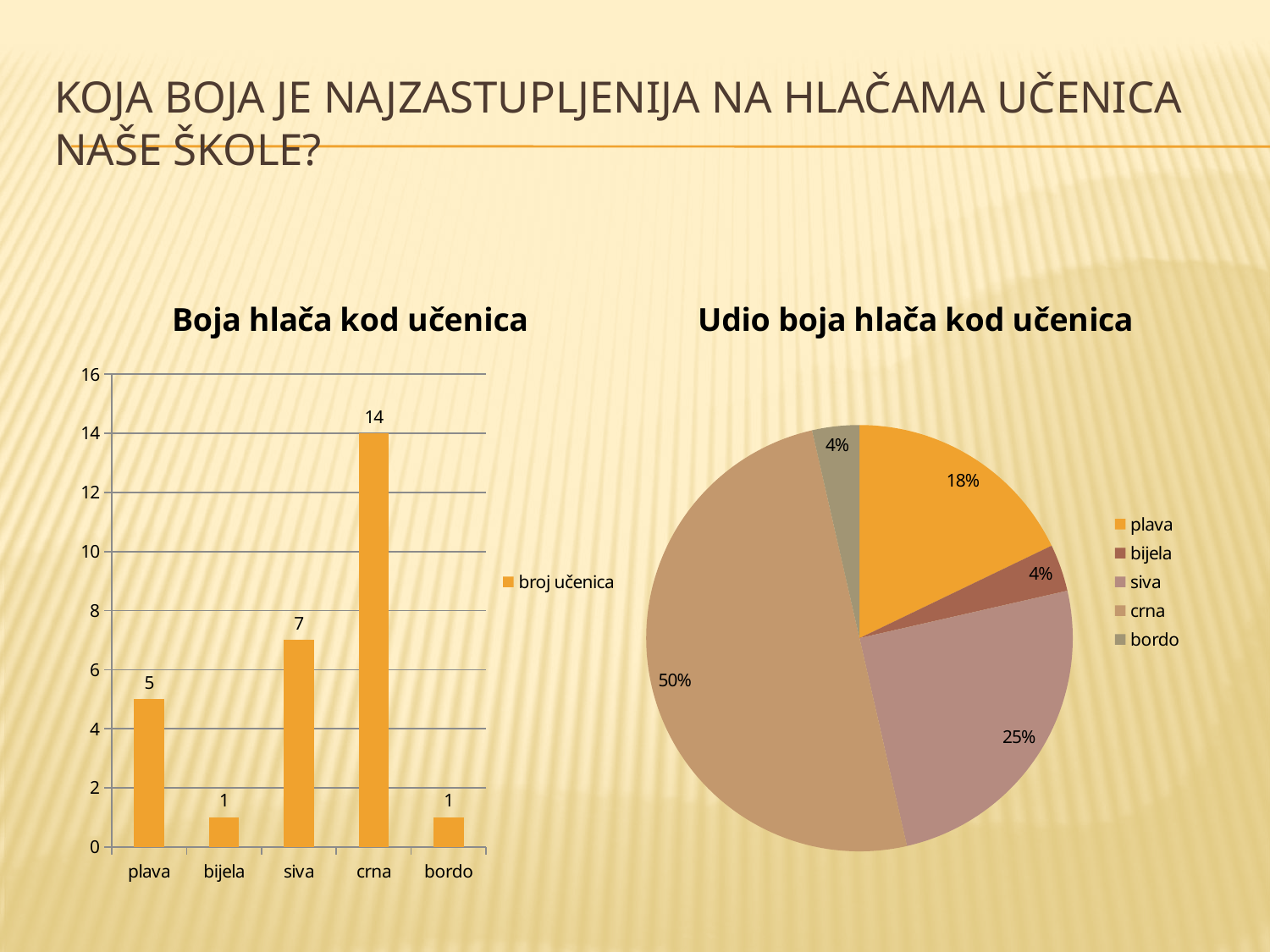
In the chart titled "Udio boja hlača kod učenica", which slice is the largest? crna In the chart titled "Boja hlača kod učenica", what is the value for siva? 7 In the chart titled "Boja hlača kod učenica", which category has the highest value? crna In the chart titled "Boja hlača kod učenica", what is the difference between the values for crna and plava? 9 In the chart titled "Boja hlača kod učenica", what is the name of the series shown in the legend? broj učenica What kind of chart is the chart titled "Udio boja hlača kod učenica"? pie chart What kind of chart is the chart titled "Boja hlača kod učenica"? bar chart In the chart titled "Udio boja hlača kod učenica", what share does crna have? 50% In the chart titled "Udio boja hlača kod učenica", what share does plava have? 18% In the chart titled "Boja hlača kod učenica", what is the value for crna? 14 In the chart titled "Boja hlača kod učenica", which is larger, the value for plava or the value for siva? siva In the chart titled "Boja hlača kod učenica", how many categories are shown on the x axis? 5